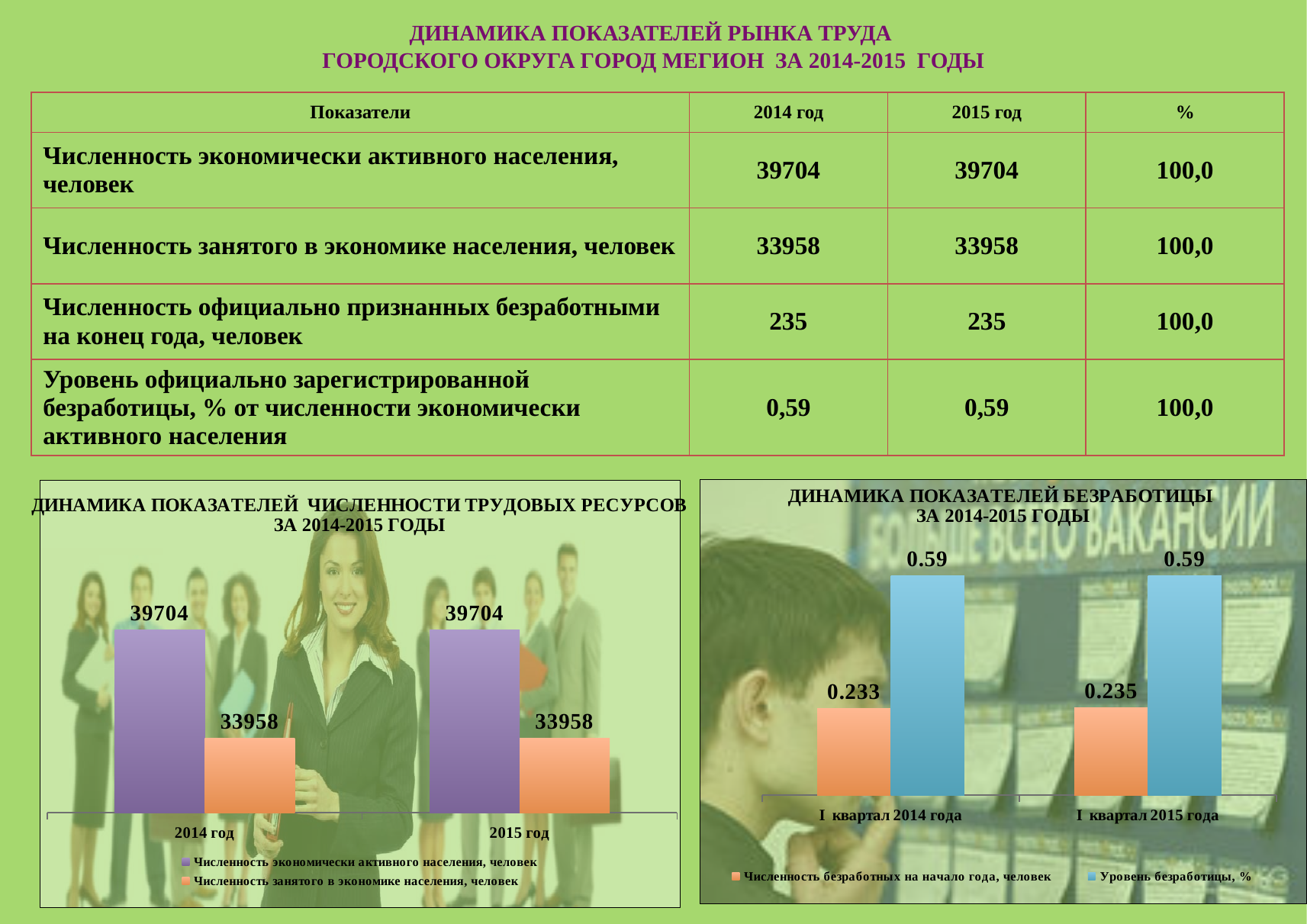
In the right chart (ДИНАМИКА ПОКАЗАТЕЛЕЙ БЕЗРАБОТИЦЫ), how many categories are shown on the x axis? 2 In the left chart (ДИНАМИКА ПОКАЗАТЕЛЕЙ ЧИСЛЕННОСТИ ТРУДОВЫХ РЕСУРСОВ), how many series does the legend list? 2 In the left chart (ДИНАМИКА ПОКАЗАТЕЛЕЙ ЧИСЛЕННОСТИ ТРУДОВЫХ РЕСУРСОВ), what is the value of Численность экономически активного населения for 2014 год? 39704 In the right chart (ДИНАМИКА ПОКАЗАТЕЛЕЙ БЕЗРАБОТИЦЫ), what is the value of Численность безработных на начало года for I квартал 2014 года? 0.233 In the right chart (ДИНАМИКА ПОКАЗАТЕЛЕЙ БЕЗРАБОТИЦЫ), what is the difference between the Численность безработных values for I квартал 2015 года and I квартал 2014 года? 0.002 What kind of chart is the left chart (ДИНАМИКА ПОКАЗАТЕЛЕЙ ЧИСЛЕННОСТИ ТРУДОВЫХ РЕСУРСОВ)? bar chart In the left chart (ДИНАМИКА ПОКАЗАТЕЛЕЙ ЧИСЛЕННОСТИ ТРУДОВЫХ РЕСУРСОВ), what is the value of Численность занятого в экономике населения for 2015 год? 33958 In the left chart (ДИНАМИКА ПОКАЗАТЕЛЕЙ ЧИСЛЕННОСТИ ТРУДОВЫХ РЕСУРСОВ), does the economically active population rise, fall or stay the same from 2014 год to 2015 год? stays the same In the left chart (ДИНАМИКА ПОКАЗАТЕЛЕЙ ЧИСЛЕННОСТИ ТРУДОВЫХ РЕСУРСОВ), what is the difference between the economically active population and the employed population in 2014 год? 5746 In the right chart (ДИНАМИКА ПОКАЗАТЕЛЕЙ БЕЗРАБОТИЦЫ), which category has the higher value for Численность безработных на начало года? I квартал 2015 года In the right chart (ДИНАМИКА ПОКАЗАТЕЛЕЙ БЕЗРАБОТИЦЫ), which colour represents Уровень безработицы, %? blue In the right chart (ДИНАМИКА ПОКАЗАТЕЛЕЙ БЕЗРАБОТИЦЫ), what is the value of Уровень безработицы for I квартал 2015 года? 0.59